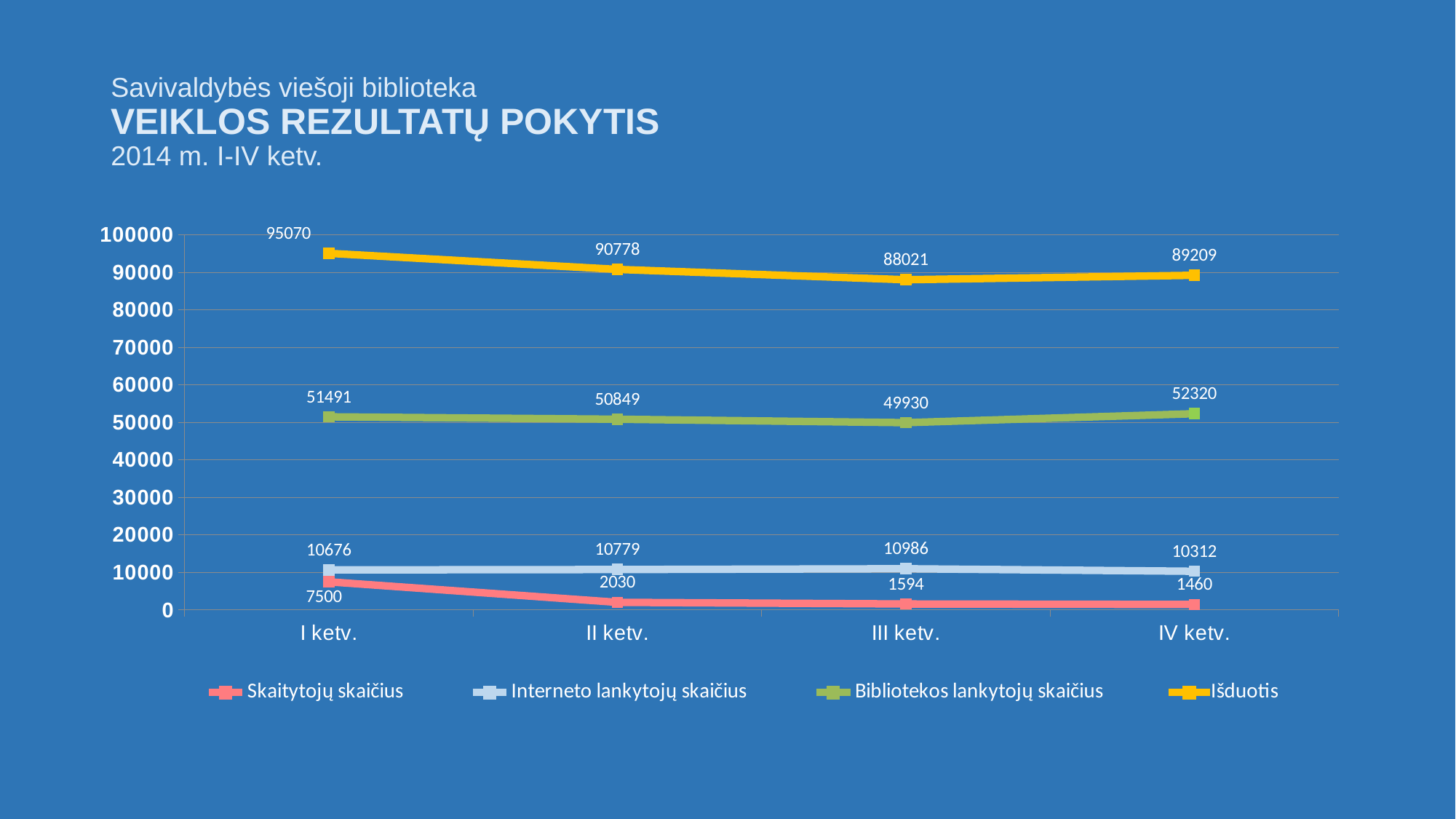
What is the value of Interneto lankytojų skaičius in II ketv.? 10779 Does Skaitytojų skaičius rise or fall from I ketv. to IV ketv.? fall In which quarter is Bibliotekos lankytojų skaičius highest? IV ketv. What is the value of Bibliotekos lankytojų skaičius in III ketv.? 49930 How many series does the legend list? 4 How many quarters are shown on the x axis? 4 What is the value of Išduotis in I ketv.? 95070 In which quarter is Išduotis lowest? III ketv. What is the value of Skaitytojų skaičius in IV ketv.? 1460 Which is larger: Skaitytojų skaičius in I ketv. or in II ketv.? I ketv. What kind of chart is shown on the slide? line chart What is the difference between Išduotis in I ketv. and IV ketv.? 5861